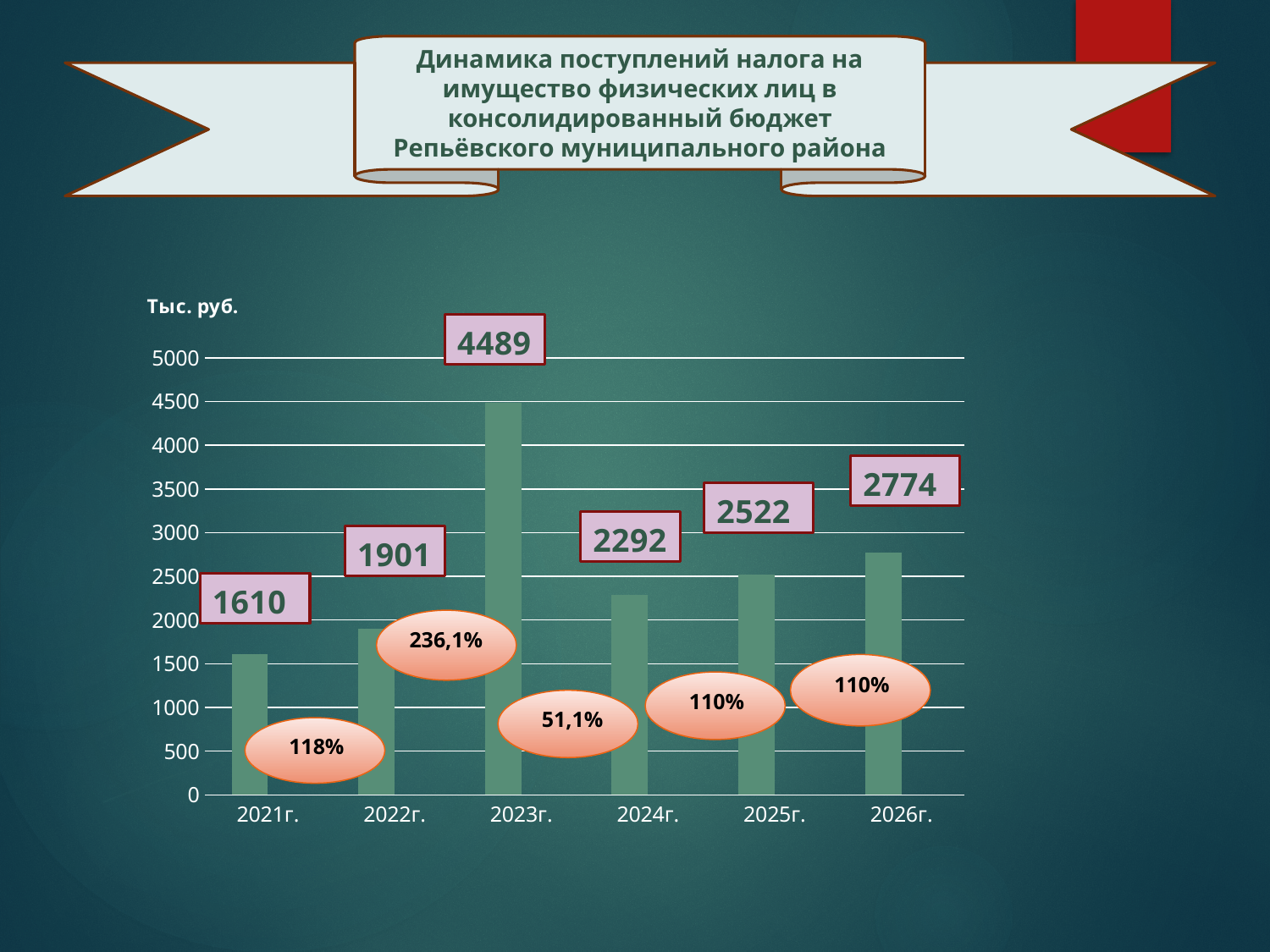
What is the difference between the values for 2023г. and 2022г.? 2588 How many years are shown on the x axis? 6 What kind of chart is shown on the slide? bar chart Which is larger, the value for 2024г. or the value for 2022г.? 2024г. What is the value for 2021г.? 1610 What is the value for 2023г.? 4489 Which year has the lowest value? 2021г. Which year has the highest value? 2023г. What percentage is shown in the oval label for 2022г.? 236,1% What unit is written above the vertical axis of the chart? Тыс. руб. What is the value for 2026г.? 2774 What is the difference between the values for 2026г. and 2025г.? 252